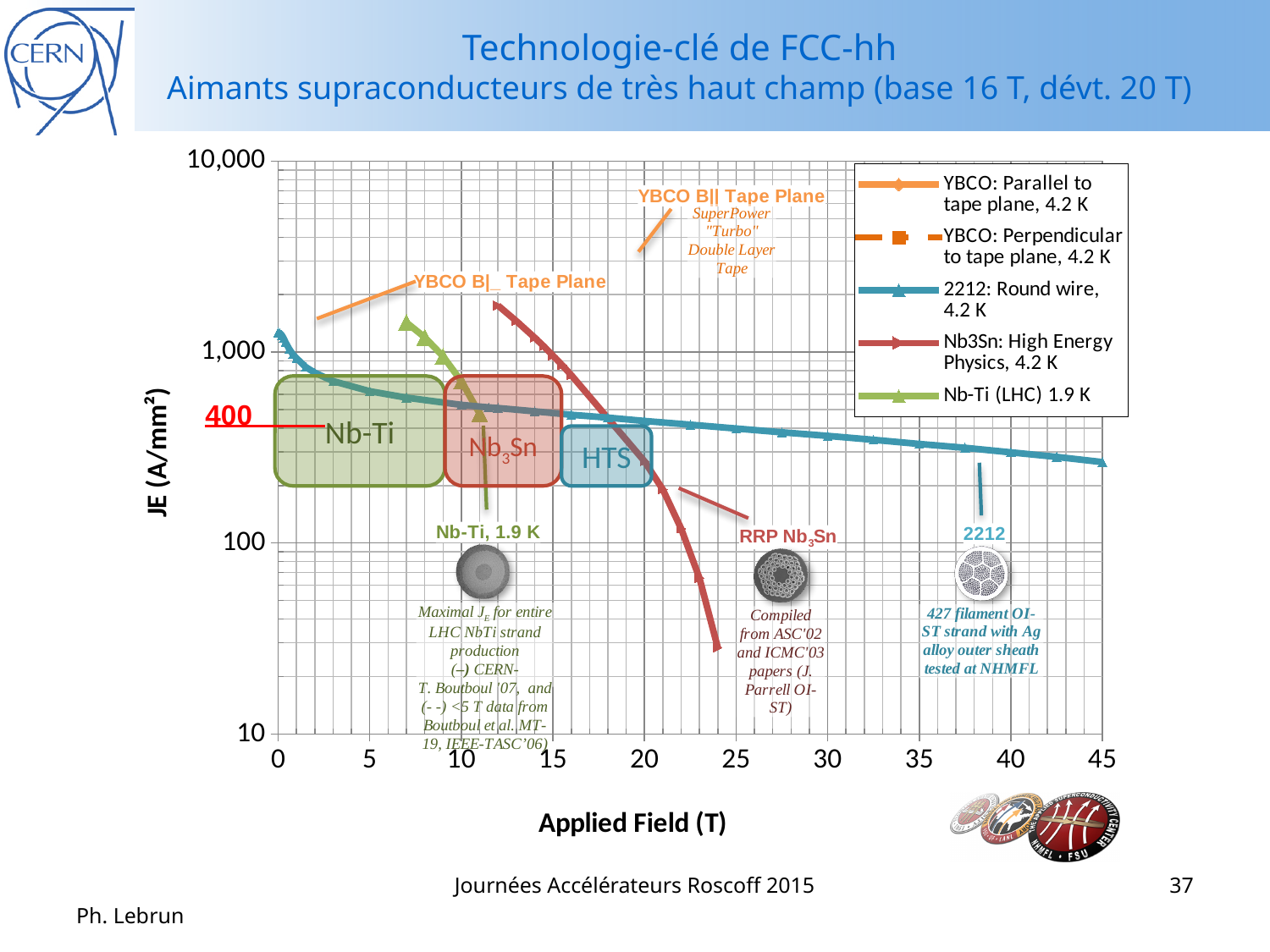
What is the highest value shown on the x axis of the chart? 45 Which series extends to the highest applied field on the chart? 2212: Round wire, 4.2 K How many series does the chart legend list? 5 What kind of chart is shown on the slide? line chart At what temperature is the Nb-Ti (LHC) series measured, according to the legend? 1.9 K Does the Nb3Sn: High Energy Physics series rise or fall as the applied field increases? fall Does the 2212: Round wire series rise or fall as the applied field increases? fall What is the label of the x axis of the chart? Applied Field (T) Is the value of the Nb3Sn: High Energy Physics series at 24 T greater or less than 100? less What is the label of the y axis of the chart? JE (A/mm²) Is the value of the 2212: Round wire series at 45 T greater or less than 400? less What is the highest value shown on the y axis of the chart? 10,000